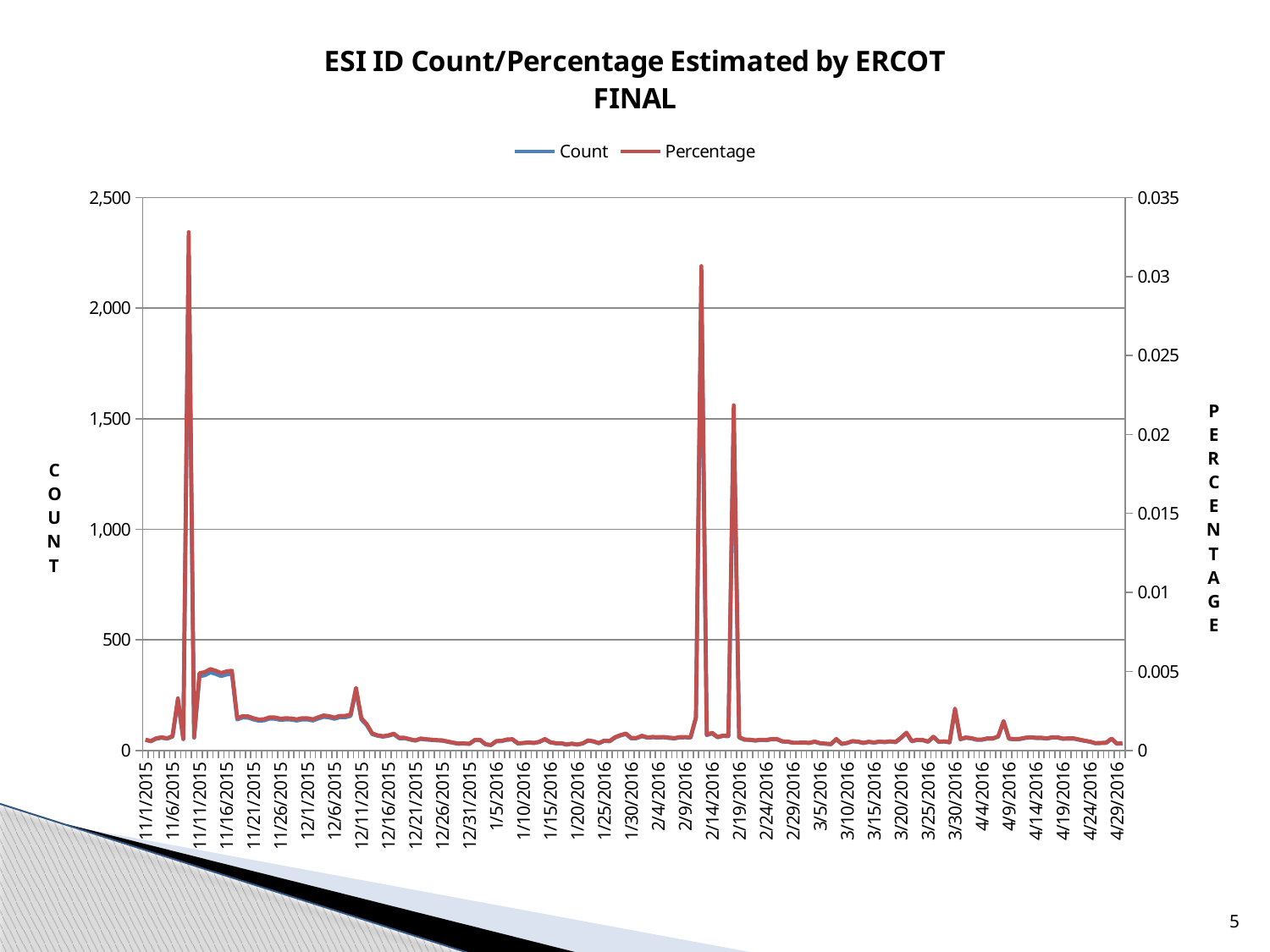
What kind of chart is shown on the slide? Line chart What are the names of the two series in the legend? Count and Percentage What is the maximum value shown on the right-hand Percentage axis? 0.035 How many series does the legend list? 2 Is the Count peak near 3/30/2016 greater or less than 500 on the left axis? less Is the Count value on 1/5/2016 greater or less than 500? less Is the Count peak near 2/19/2016 greater or less than 2,000 on the left axis? less What is the maximum value shown on the left-hand Count axis? 2,500 Which is higher: the Count peak near 2/14/2016 or the Count peak near 2/19/2016? The peak near 2/14/2016 What is the title of the chart? ESI ID Count/Percentage Estimated by ERCOT FINAL